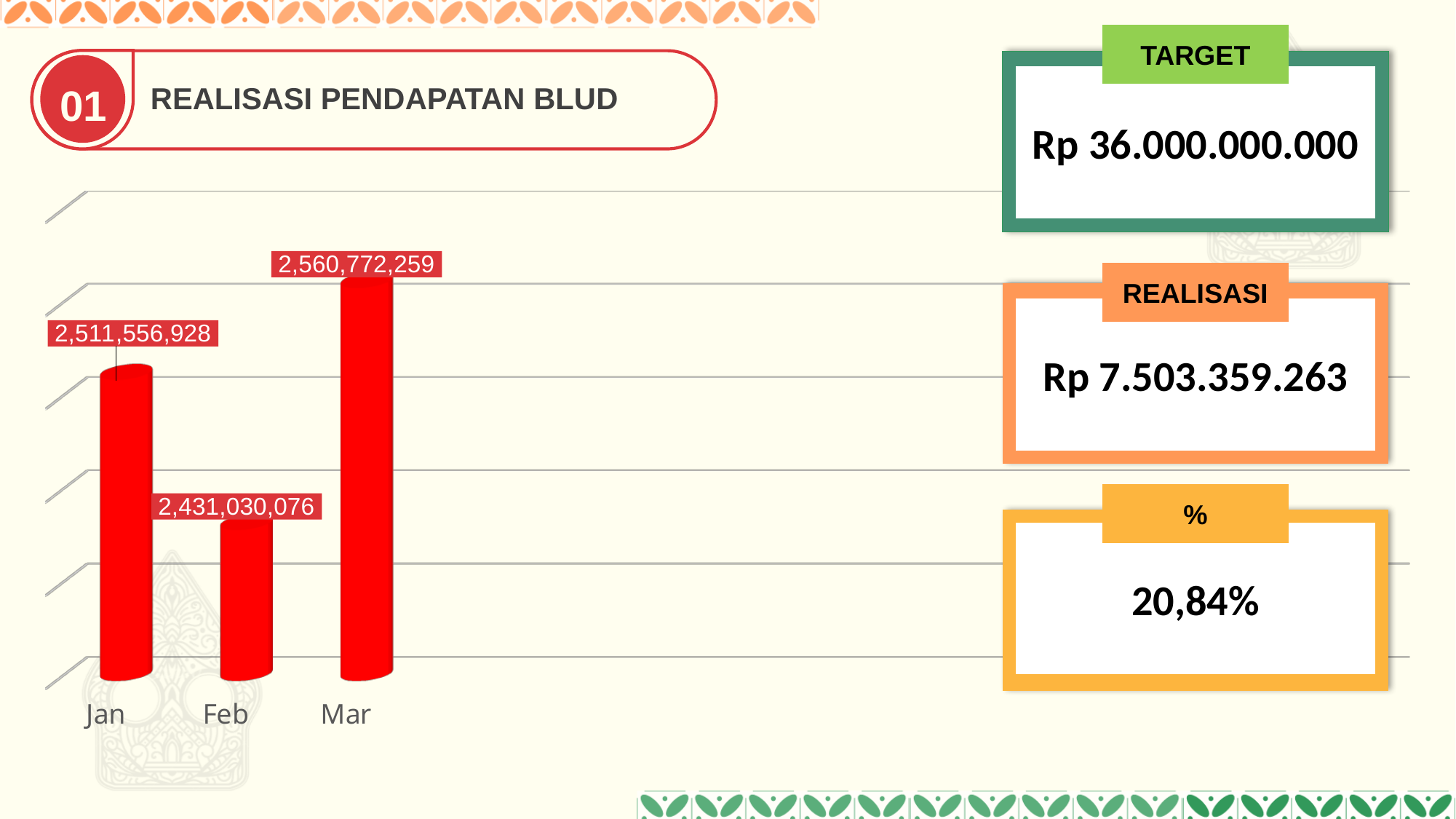
Which month has the lowest value? Feb What colour are the bars in the chart? red What kind of chart is shown on the slide? bar chart How many months are shown on the chart? 3 What is the difference between the values for Jan and Feb? 80,526,852 What is the value for Feb? 2,431,030,076 Does the value rise or fall from Feb to Mar? rise Which month has the highest value? Mar What is the value for Jan? 2,511,556,928 Which is larger, the value for Jan or the value for Feb? Jan What is the value for Mar? 2,560,772,259 What is the difference between the values for Mar and Jan? 49,215,331